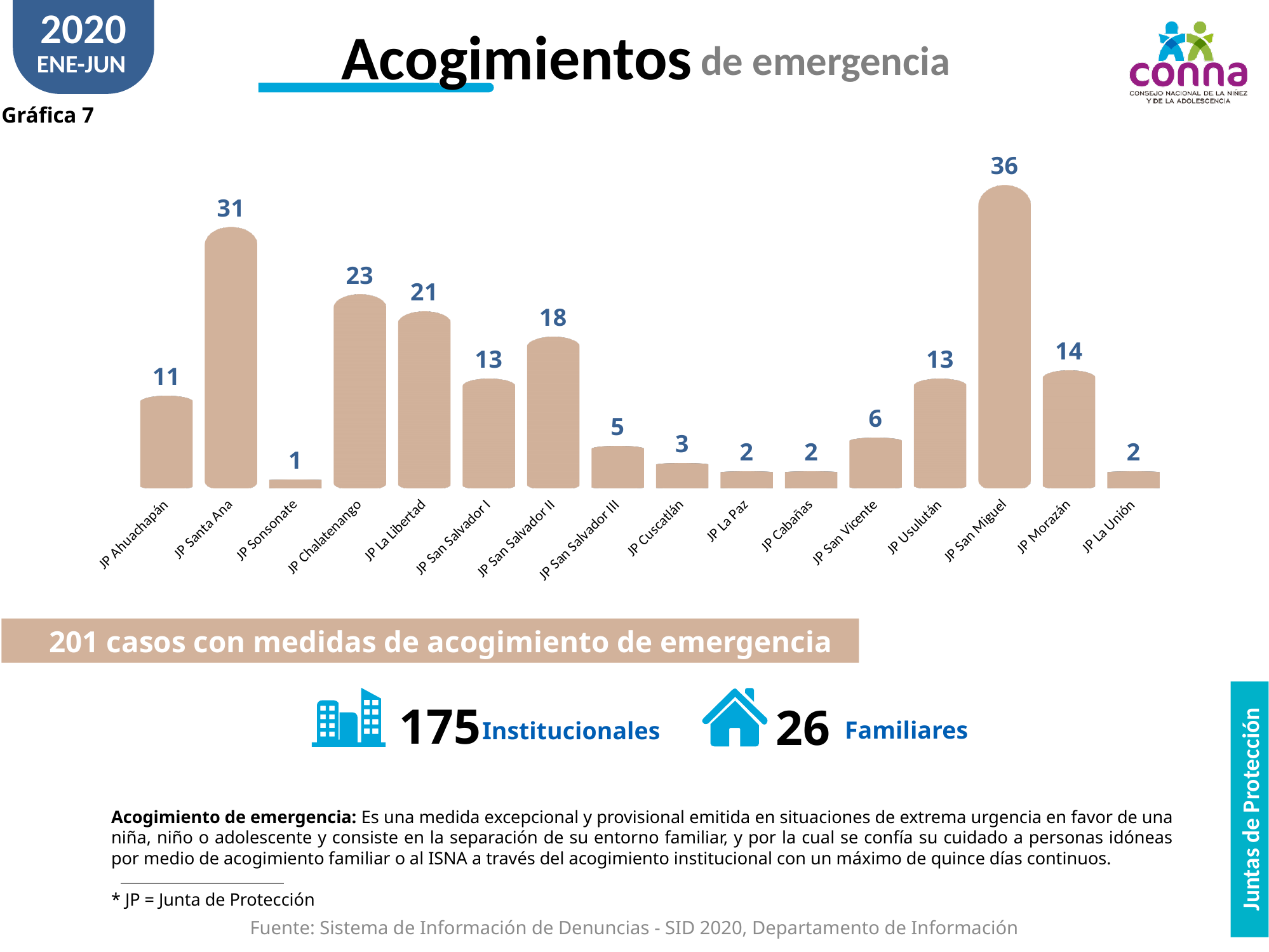
What is the value for JP Santa Ana? 31 Which category has the lowest value? JP Sonsonate Which is larger, the value for JP Chalatenango or JP La Libertad? JP Chalatenango What is the difference between the values for JP Morazán and JP Usulután? 1 What is the value for JP Cuscatlán? 3 What is the difference between the values for JP San Miguel and JP Santa Ana? 5 What is the value for JP San Salvador II? 18 What is the value for JP Sonsonate? 1 How many categories are shown on the x axis? 16 What kind of chart is shown? bar chart Which category has the highest value? JP San Miguel What is the title of the chart? Acogimientos de emergencia